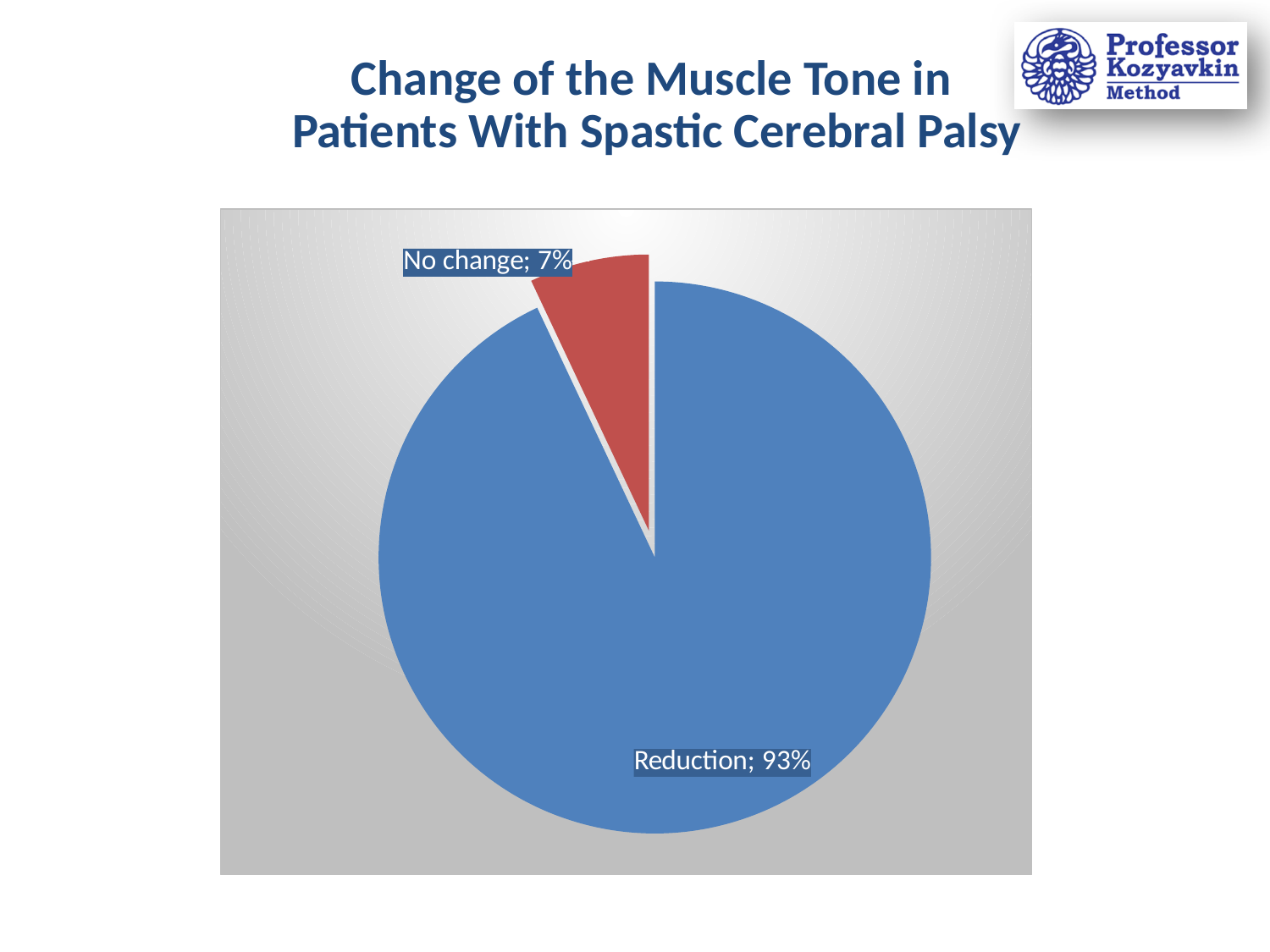
What is the combined share of the Reduction and No change slices? 100% What is the difference in percentage points between the Reduction and No change slices? 86 What is the title of the slide containing the chart? Change of the Muscle Tone in Patients With Spastic Cerebral Palsy How many slices does the pie chart have? 2 Which is larger, the Reduction slice or the No change slice? Reduction What share of patients showed no change in muscle tone? 7% Which category has the smallest slice of the pie? No change What colour is the No change slice? red Which category has the largest slice of the pie? Reduction What share of patients showed a reduction in muscle tone? 93% What kind of chart is shown on the slide? pie chart